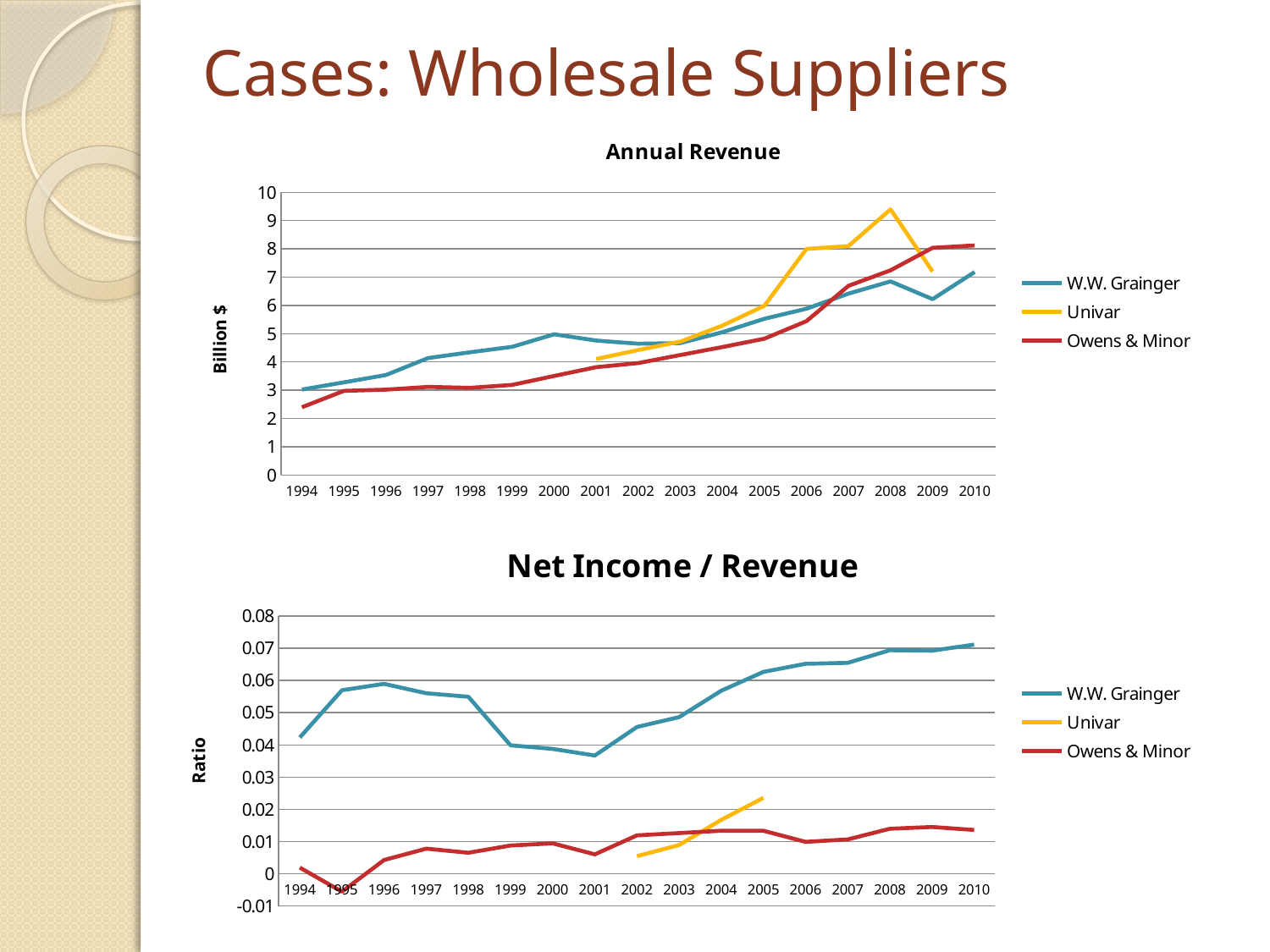
What kind of chart is the Annual Revenue chart? line chart How many years are shown on the x axis of the Net Income / Revenue chart? 17 What is the y-axis label of the Annual Revenue chart? Billion $ In the Annual Revenue chart, which series has the highest value in 2008? Univar In the Annual Revenue chart, is the value for Univar in 2008 greater or less than 9? greater How many series does the legend of the Annual Revenue chart list? 3 In the Annual Revenue chart, is the value for Owens & Minor in 1994 greater or less than 3? less In the Net Income / Revenue chart, which series has the highest value in 2010? W.W. Grainger In the Net Income / Revenue chart, is the value for W.W. Grainger in 2010 greater or less than 0.06? greater In the Annual Revenue chart, does the Owens & Minor line generally rise or fall from 1994 to 2010? rise In the Annual Revenue chart, which is larger in 2010: W.W. Grainger or Owens & Minor? Owens & Minor